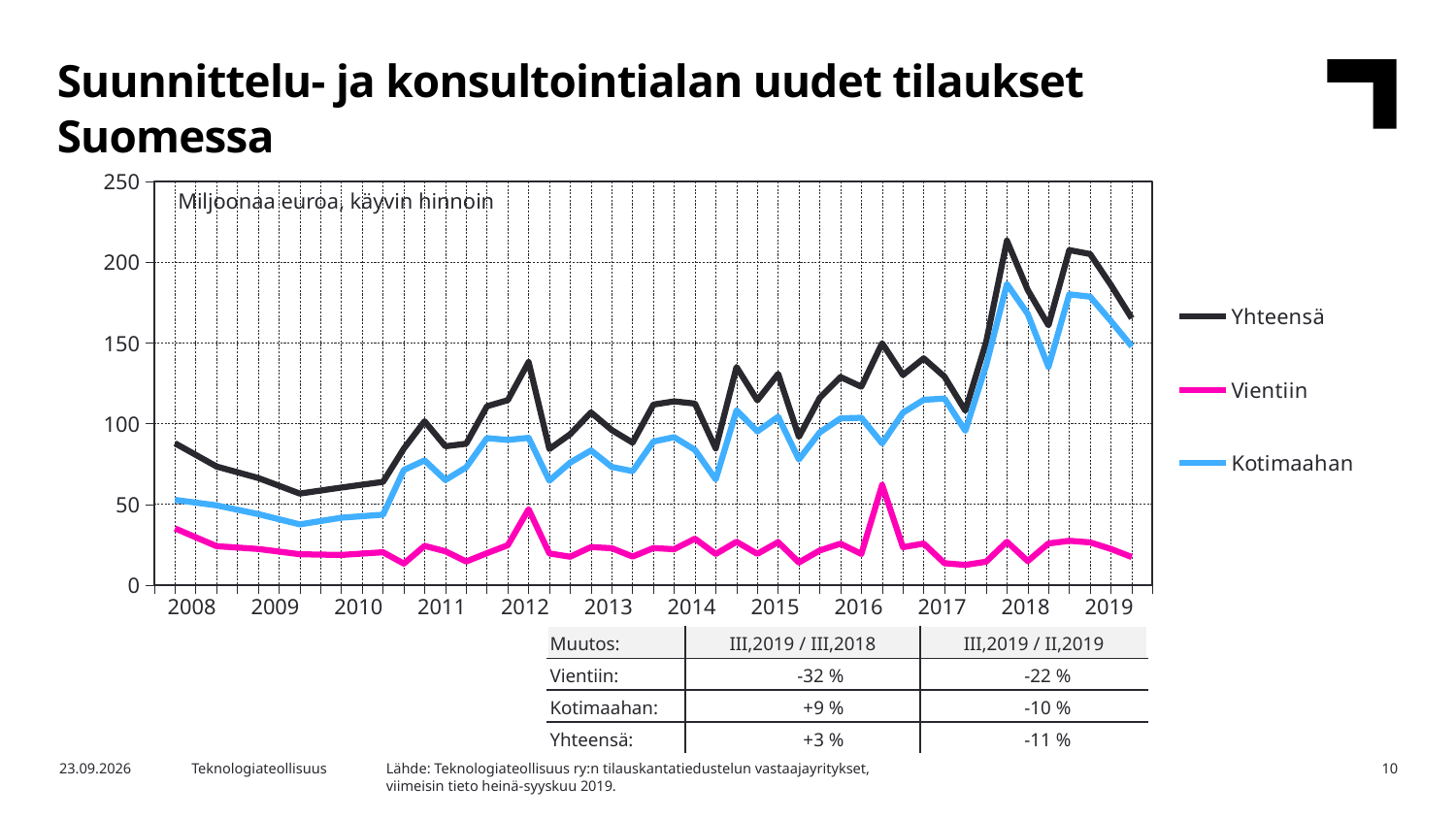
Which series is larger in 2019, Kotimaahan or Vientiin? Kotimaahan How many year labels are shown on the x axis? 12 Is the value of Yhteensä at the start of 2008 greater or less than 100? less Which series has the lowest values throughout the chart? Vientiin Which series has the highest values throughout the chart? Yhteensä Is the peak value of Kotimaahan around the end of 2017 greater or less than 150? greater What are the series names listed in the legend? Yhteensä, Vientiin, Kotimaahan Is the peak value of Yhteensä around the end of 2017 greater or less than 200? greater How many series does the legend list? 3 What unit is stated in the note inside the chart area? Miljoonaa euroa, käyvin hinnoin What kind of chart is shown on the slide? line chart Does the Yhteensä series overall rise or fall from 2008 to 2019? rise